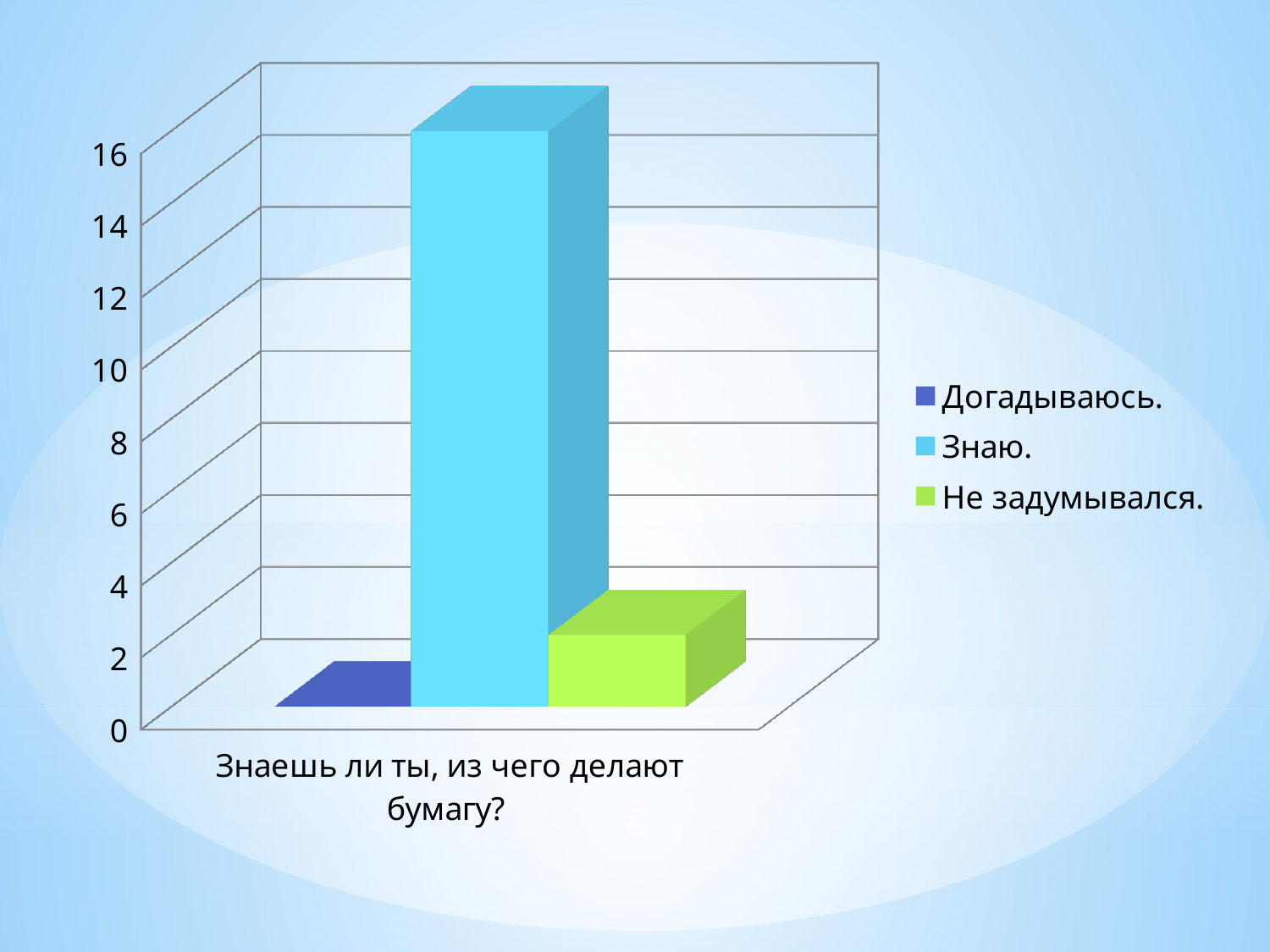
What kind of chart is shown on the slide? bar chart How many categories are shown on the x axis? 1 Which is larger, the value for Не задумывался. or the value for Догадываюсь.? Не задумывался. Is the value for Не задумывался. greater or less than 4? less What is the category label shown on the x axis? Знаешь ли ты, из чего делают бумагу? Is the value for Догадываюсь. greater or less than 2? less Which is larger, the value for Знаю. or the value for Не задумывался.? Знаю. Is the value for Знаю. greater or less than 14? greater Which series has the lowest value? Догадываюсь. Which series is shown in green in the legend? Не задумывался. Which series has the highest value? Знаю. How many series does the legend list? 3